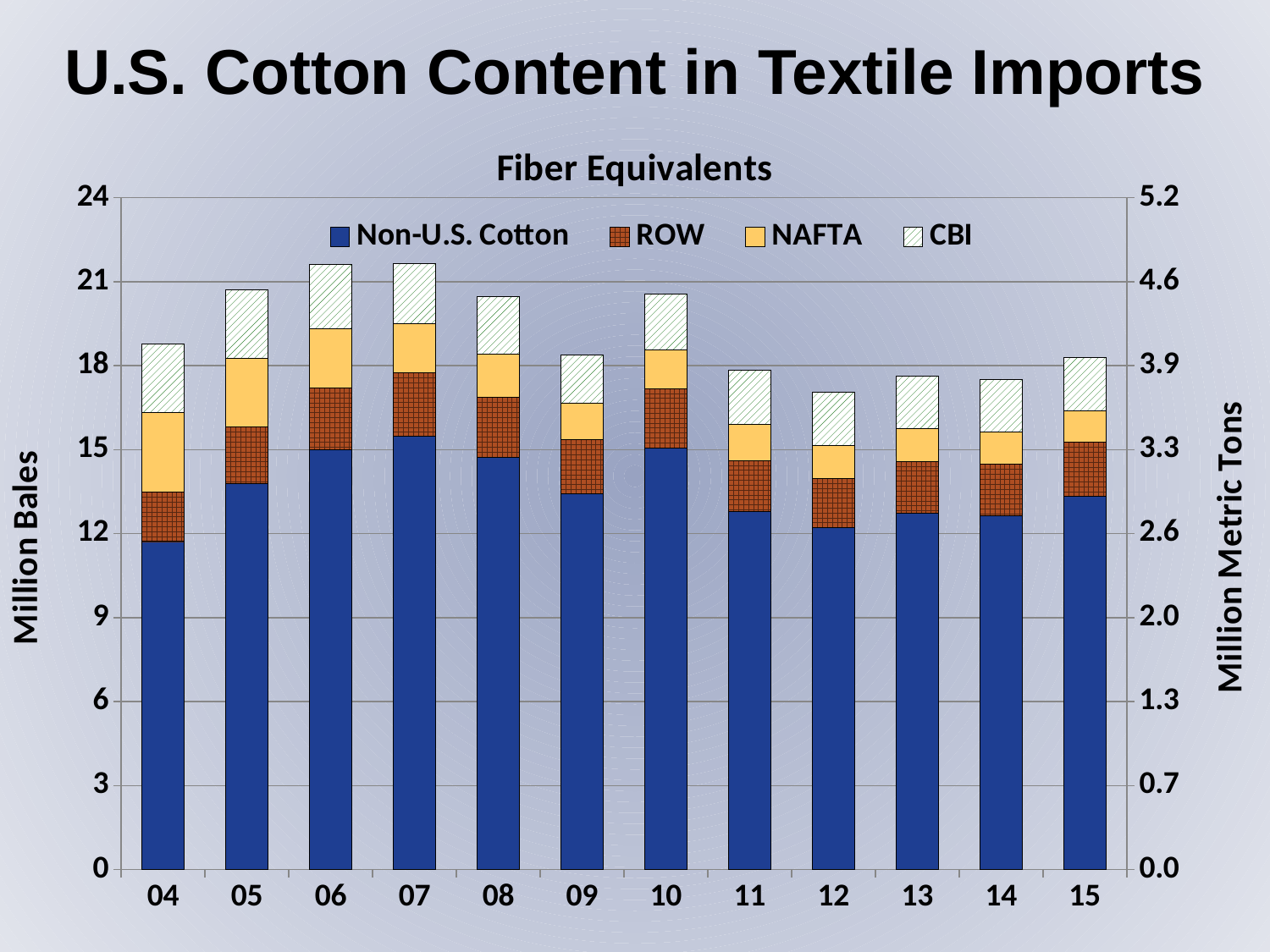
How many years are shown along the x axis? 12 Which year has the lowest Non-U.S. Cotton value? 04 Is the Non-U.S. Cotton value for 07 greater or less than 15 million bales? greater Is the total stacked bar for 06 greater or less than 21 million bales? greater Do the total stacked bars rise or fall from 10 to 12? fall How many series does the legend list? 4 Which year has the taller total stacked bar, 04 or 05? 05 Is the Non-U.S. Cotton value for 04 greater or less than 12 million bales? less Which year has the taller total stacked bar, 10 or 11? 10 What is the label of the left vertical axis? Million Bales What kind of chart is shown on the slide? Stacked bar chart